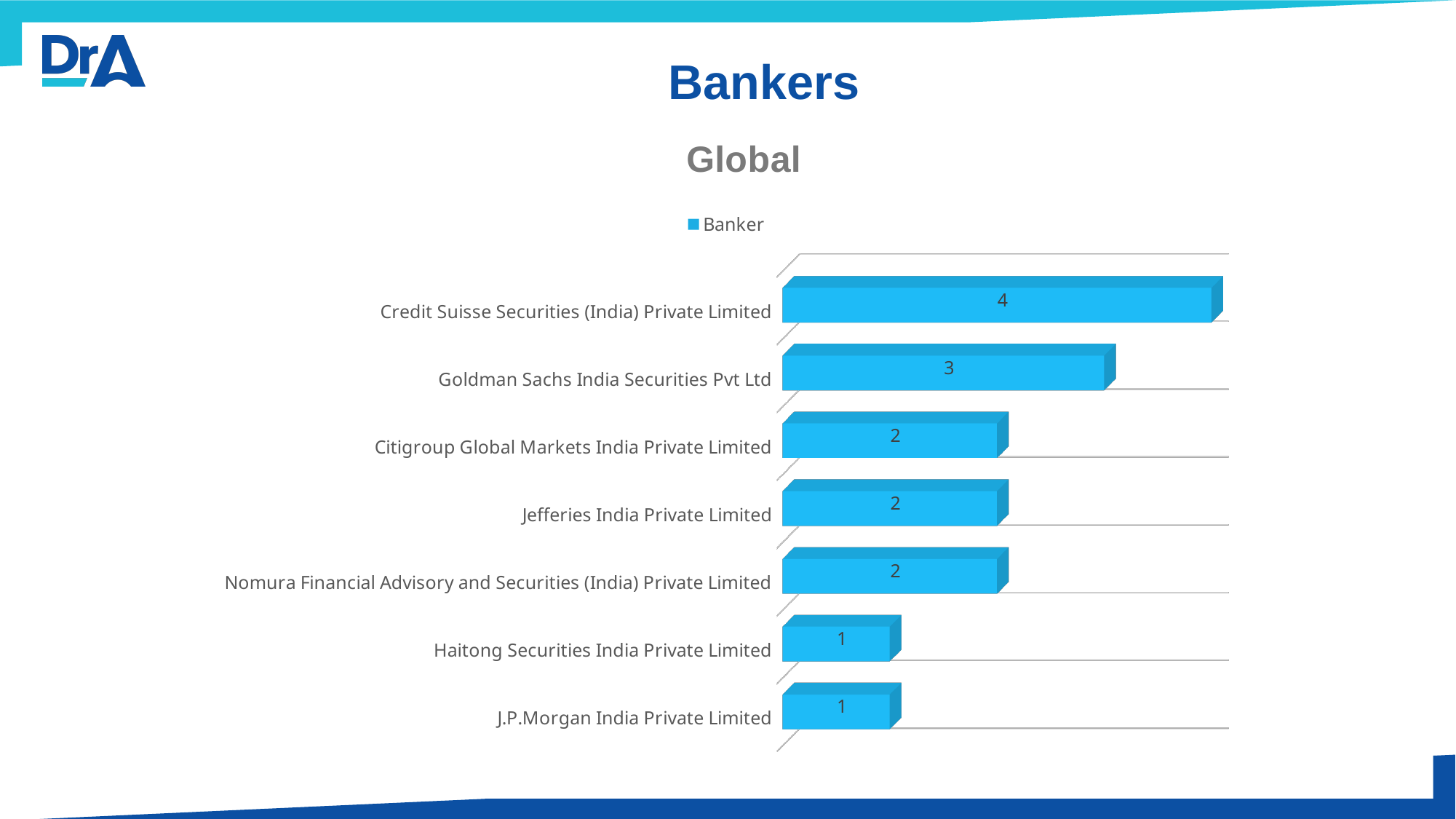
What is the value for Haitong Securities India Private Limited? 1 What is the difference between the values for Credit Suisse Securities (India) Private Limited and Goldman Sachs India Securities Pvt Ltd? 1 What is the value for Nomura Financial Advisory and Securities (India) Private Limited? 2 What kind of chart is shown on the slide? Bar chart What is the value for Goldman Sachs India Securities Pvt Ltd? 3 How many series does the legend list? 1 Which is larger, the value for Citigroup Global Markets India Private Limited or the value for J.P.Morgan India Private Limited? Citigroup Global Markets India Private Limited What is the name of the series in the legend? Banker What is the title of the chart? Global Which banker has the highest value? Credit Suisse Securities (India) Private Limited How many bankers are shown in the chart? 7 What is the value for Credit Suisse Securities (India) Private Limited? 4